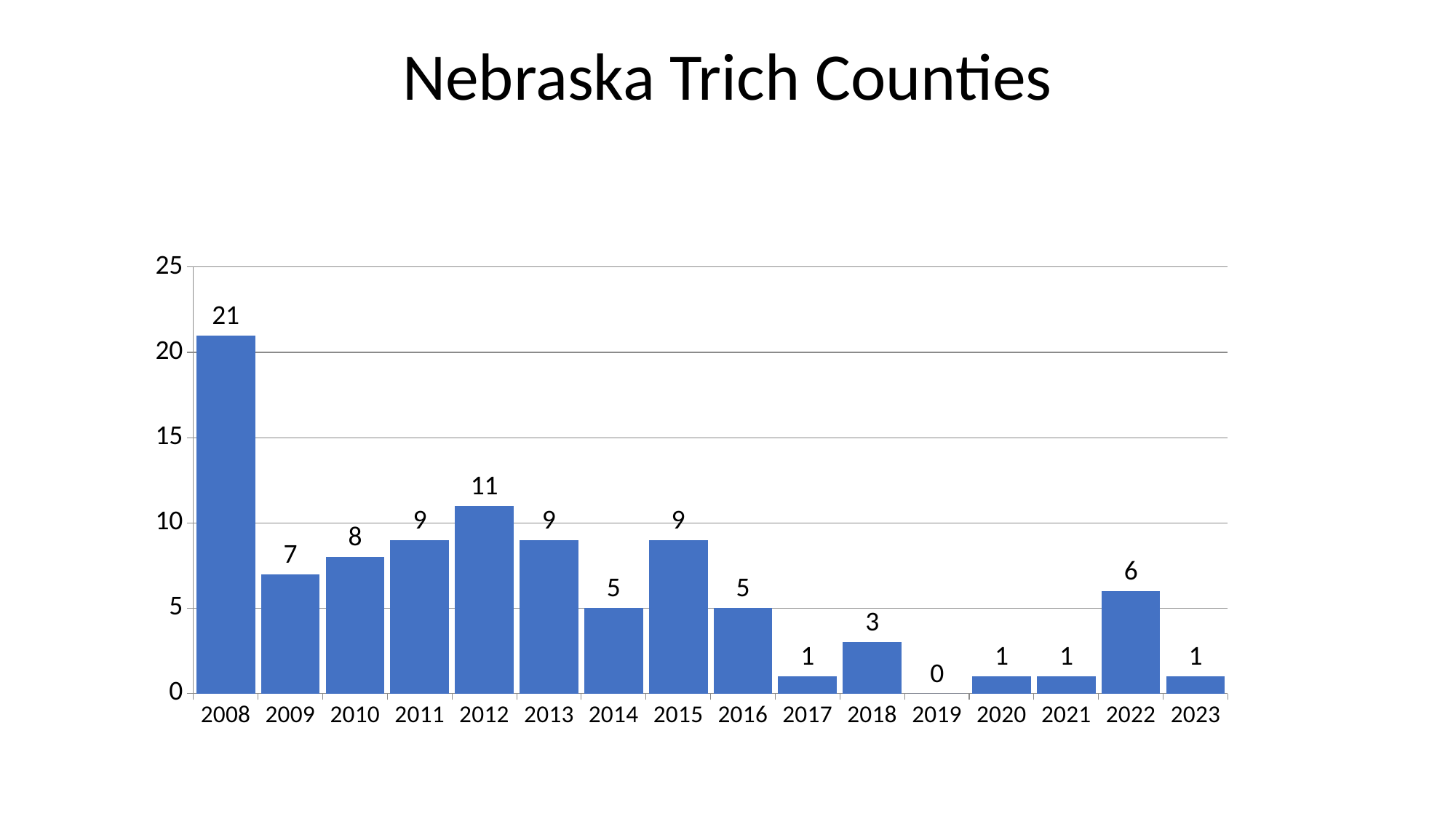
What is the difference between the values for 2008 and 2012? 10 What is the value for 2012? 11 Which is larger, the value for 2010 or the value for 2016? 2010 What is the value for 2008? 21 Which year has the lowest value? 2019 What kind of chart is this? bar chart How many years are shown on the x axis? 16 Which year has the highest value? 2008 What is the value for 2022? 6 What is the title of the chart? Nebraska Trich Counties Do the values generally rise or fall from 2008 to 2023? fall Is the value for 2008 greater or less than 20? greater